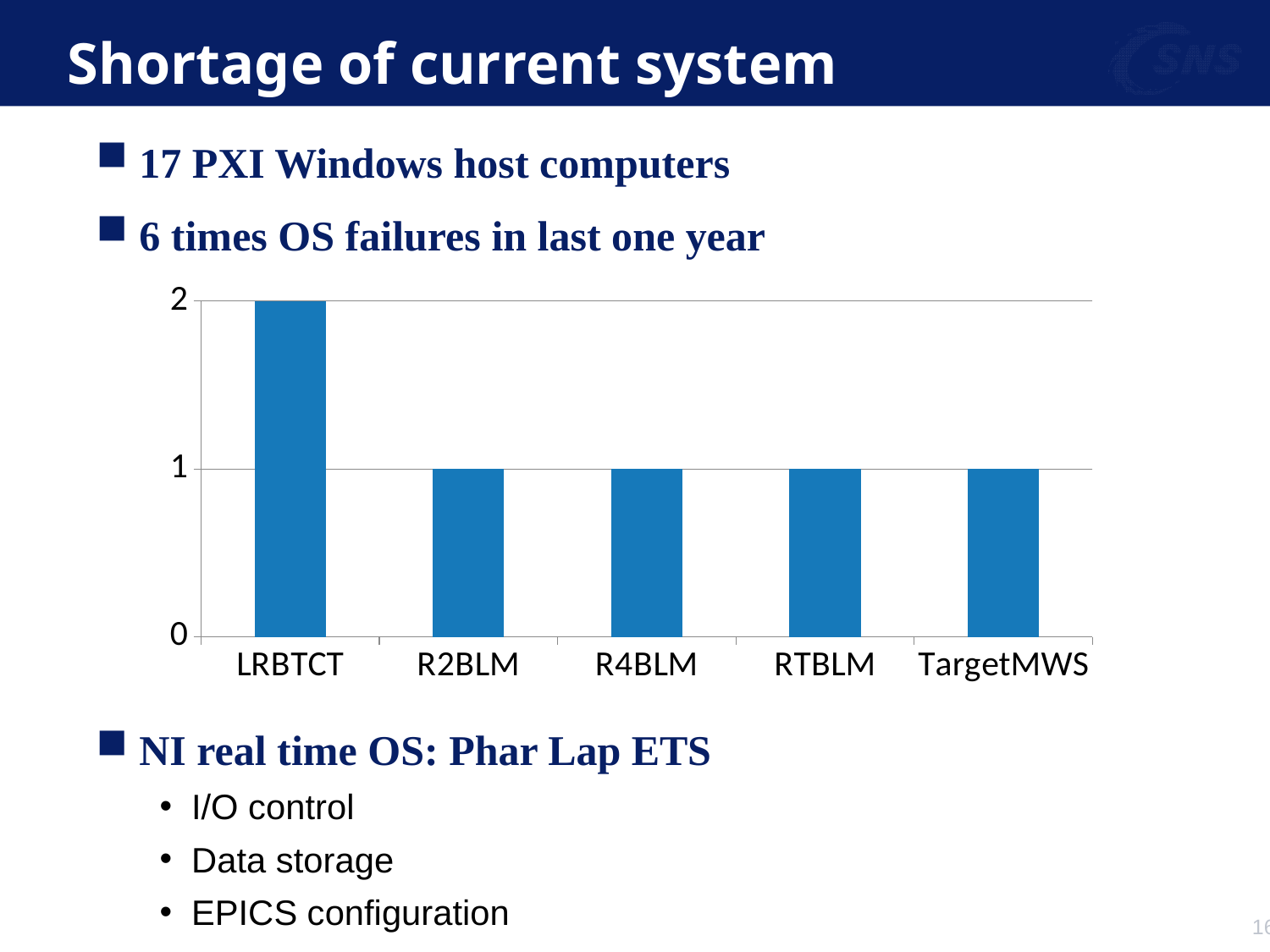
What kind of chart is shown on the slide? bar chart What is the value for R2BLM? 1 What is the total of all the bars in the chart? 6 What is the value for RTBLM? 1 What is the difference between the values for LRBTCT and R4BLM? 1 What is the value for TargetMWS? 1 Which is larger, the value for LRBTCT or the value for R2BLM? LRBTCT What colour are the bars in the chart? blue Which category has the highest value? LRBTCT What is the highest tick value shown on the y axis? 2 How many categories are shown on the x axis of the chart? 5 What is the value for LRBTCT? 2